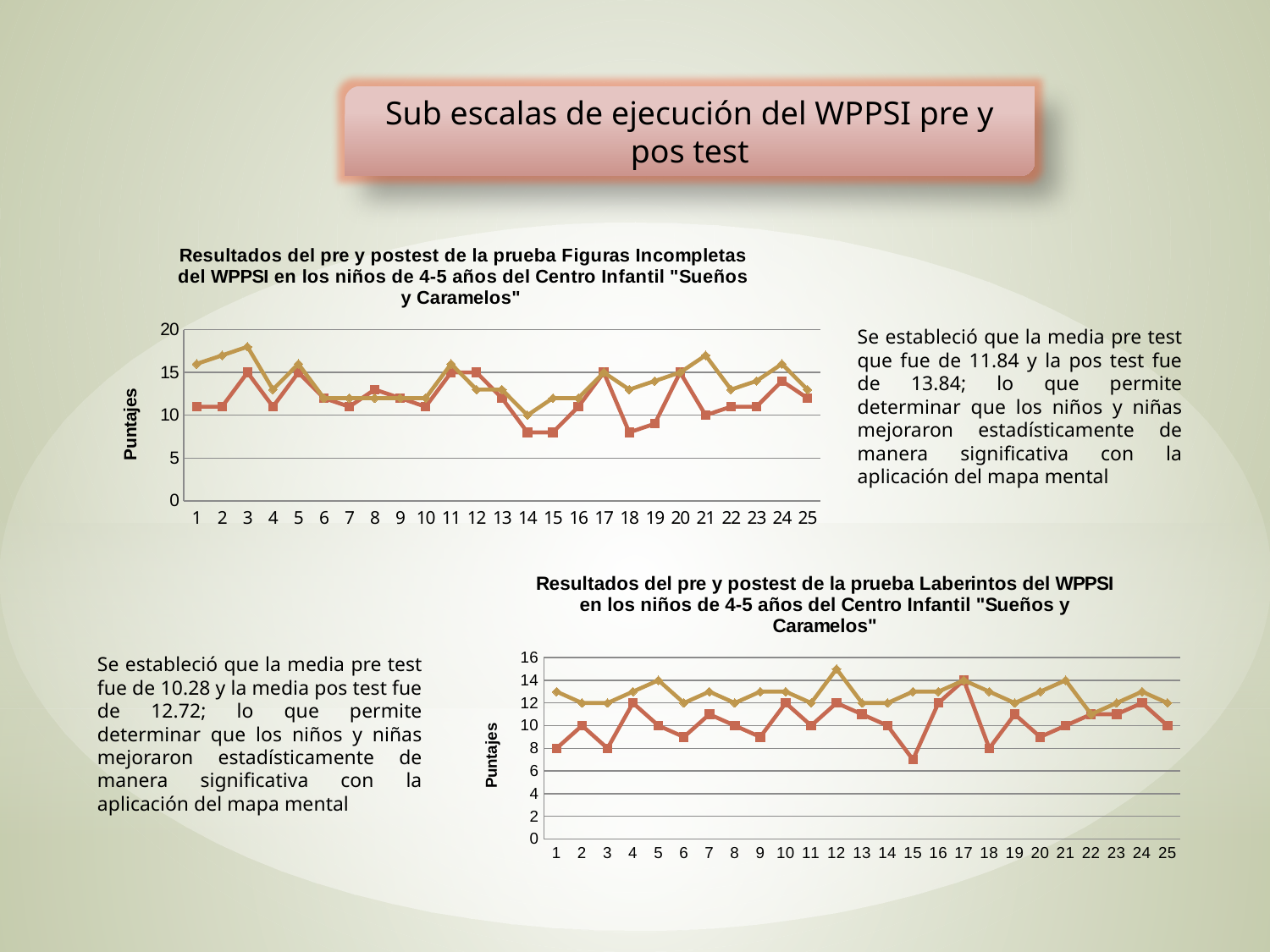
In the bottom chart (Laberintos), at which point does the red line reach its lowest value? 15 In the bottom chart (Laberintos), what is the value of the red line at point 25? 10 In the top chart (Figuras Incompletas), is the value of the red line at point 14 greater or less than 10? less How many lines are plotted in the bottom chart (Laberintos)? 2 In the bottom chart (Laberintos), what is the value of the red line at point 1? 8 What kind of chart is the top chart, 'Resultados del pre y postest de la prueba Figuras Incompletas'? Line chart In the top chart (Figuras Incompletas), is the value of the gold line at point 3 greater or less than 15? greater How many points are plotted along the x axis of the top chart (Figuras Incompletas)? 25 In the top chart (Figuras Incompletas), at point 1, which line has the higher value, the red line or the gold line? The gold line How many points are plotted along the x axis of the bottom chart (Laberintos)? 25 What is the y-axis label of the top chart (Figuras Incompletas)? Puntajes In the bottom chart (Laberintos), at which point does the gold line reach its highest value? 12